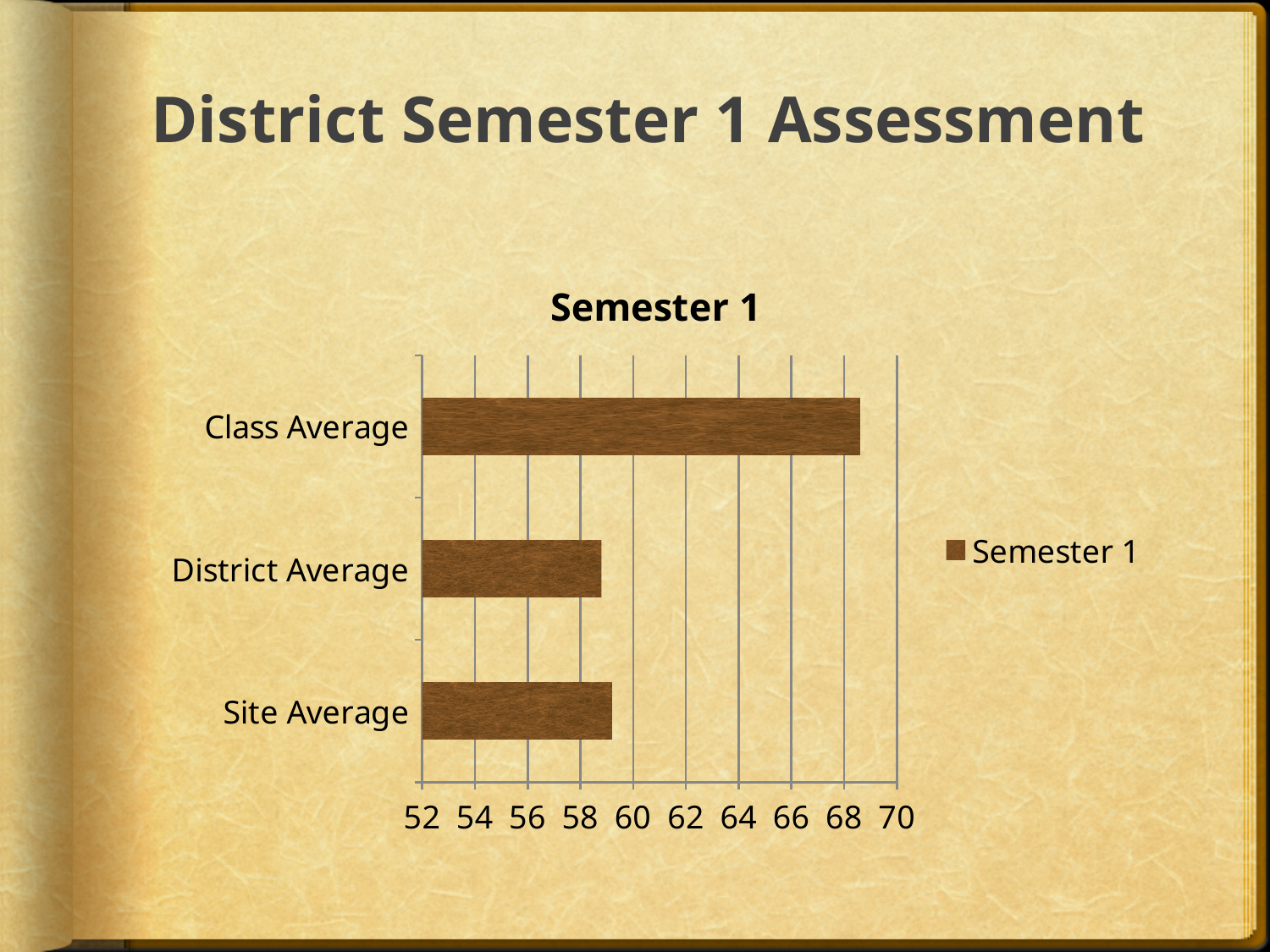
How many categories are plotted in the chart? 3 Is the value for Site Average greater or less than 60? less What is the name of the series shown in the legend? Semester 1 Is the value for District Average greater or less than 56? greater Which is larger, the value for Site Average or the value for Class Average? Class Average Which category has the highest value? Class Average What is the title of the chart? Semester 1 How many series does the legend list? 1 What kind of chart is shown on the slide? bar chart Is the value for Class Average greater or less than 66? greater Which is larger, the value for Class Average or the value for District Average? Class Average